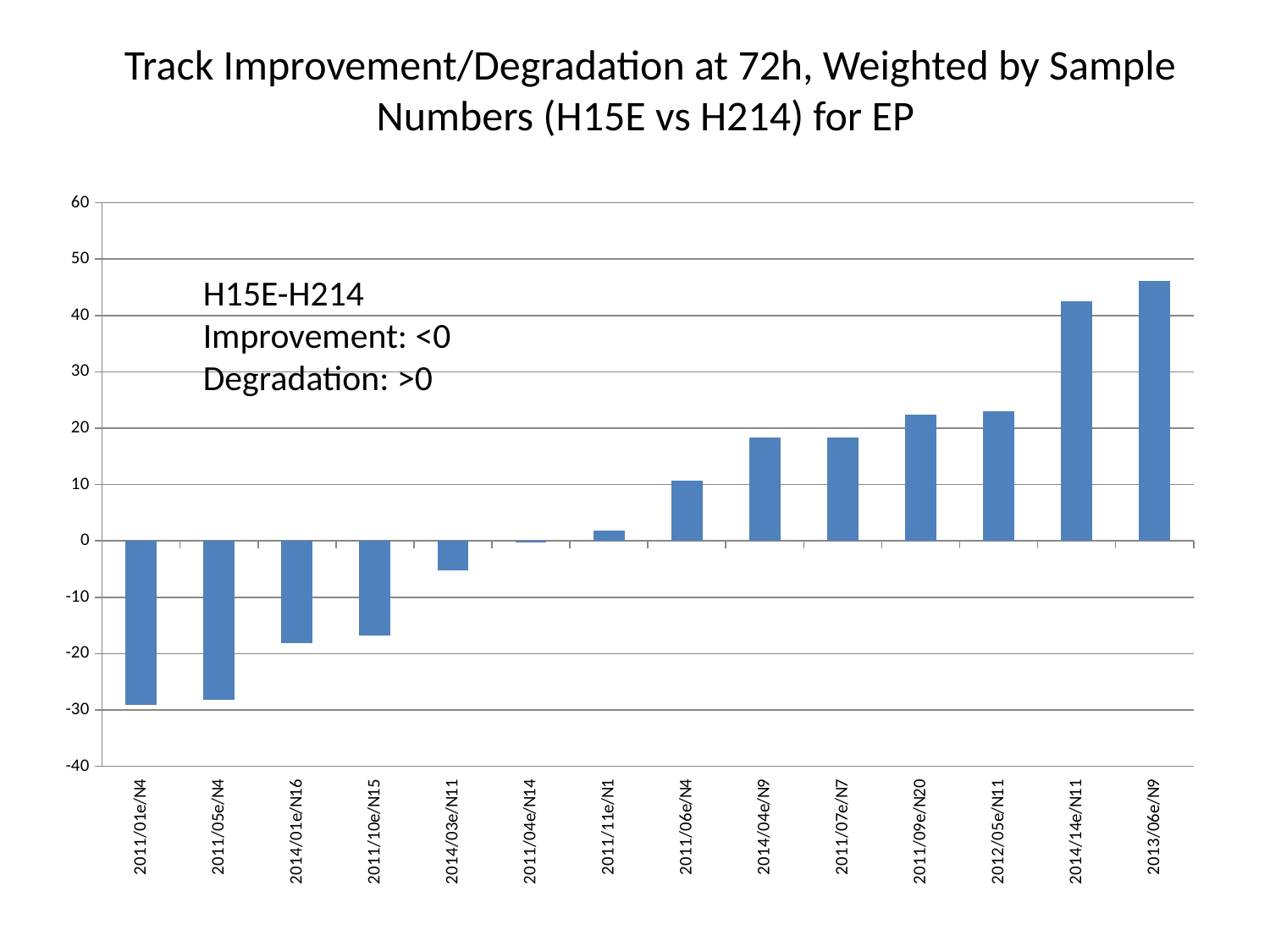
Is the value for 2011/01e/N4 greater or less than -20? less What kind of chart is shown on the slide? bar chart According to the text on the chart, does a value below 0 indicate improvement or degradation? Improvement How many categories are plotted along the x axis? 14 Which has the larger value, 2014/14e/N11 or 2011/09e/N20? 2014/14e/N11 Which has the larger value, 2011/11e/N1 or 2014/03e/N11? 2011/11e/N1 Is the value for 2014/14e/N11 greater or less than 30? greater Which category has the highest value? 2013/06e/N9 Is the value for 2014/01e/N16 greater or less than -10? less Do the values generally rise or fall from left to right along the x axis? rise